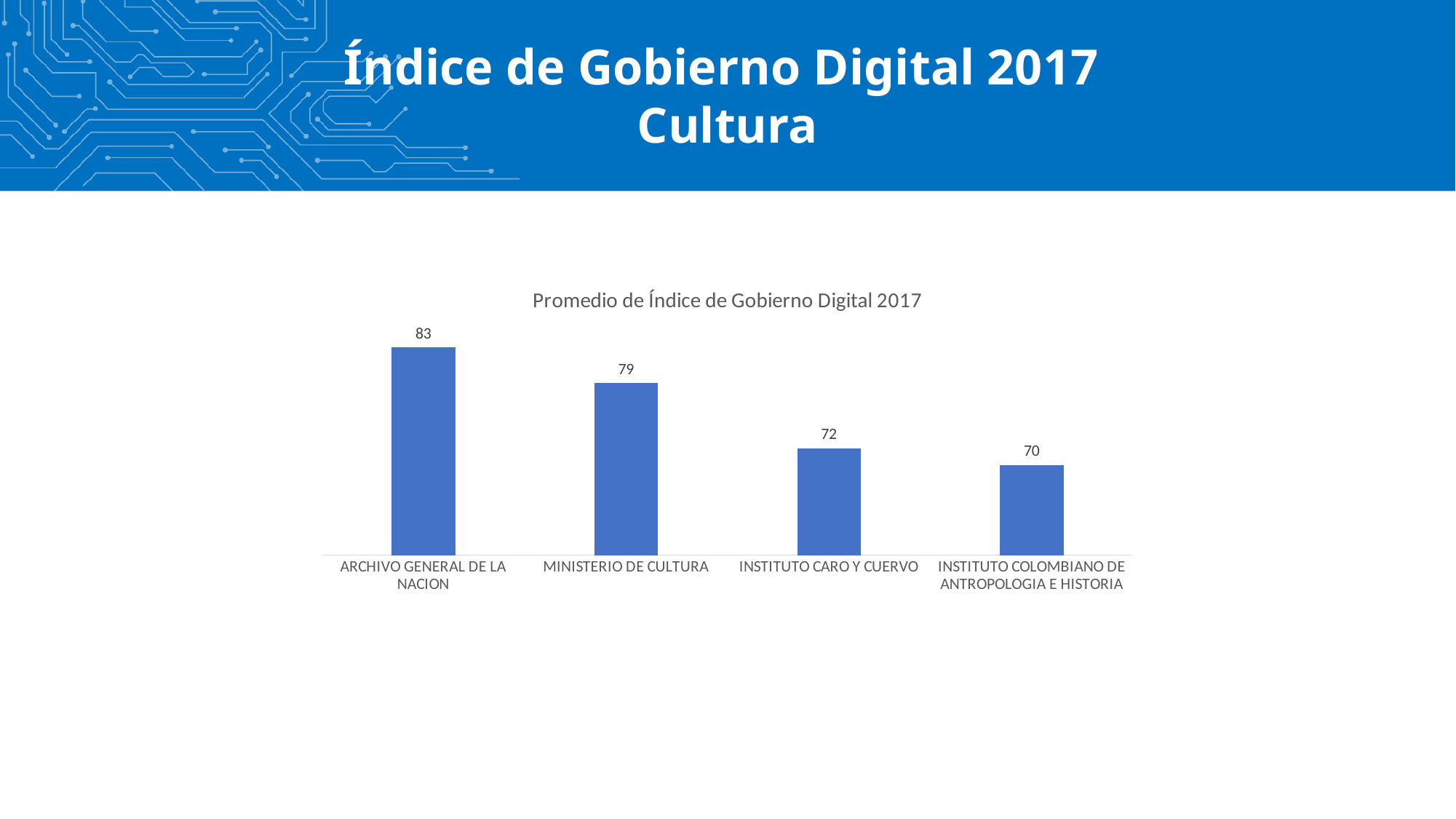
Which is larger, the value for MINISTERIO DE CULTURA or the value for INSTITUTO CARO Y CUERVO? MINISTERIO DE CULTURA What is the value for ARCHIVO GENERAL DE LA NACION? 83 What is the difference between the values for ARCHIVO GENERAL DE LA NACION and MINISTERIO DE CULTURA? 4 How many categories are shown in the chart? 4 Which category has the lowest value? INSTITUTO COLOMBIANO DE ANTROPOLOGIA E HISTORIA Which category has the highest value? ARCHIVO GENERAL DE LA NACION What is the value for INSTITUTO CARO Y CUERVO? 72 What is the value for INSTITUTO COLOMBIANO DE ANTROPOLOGIA E HISTORIA? 70 What is the value for MINISTERIO DE CULTURA? 79 What kind of chart is shown on the slide? Bar chart What is the title of the chart? Promedio de Índice de Gobierno Digital 2017 What is the difference between the values for INSTITUTO CARO Y CUERVO and INSTITUTO COLOMBIANO DE ANTROPOLOGIA E HISTORIA? 2